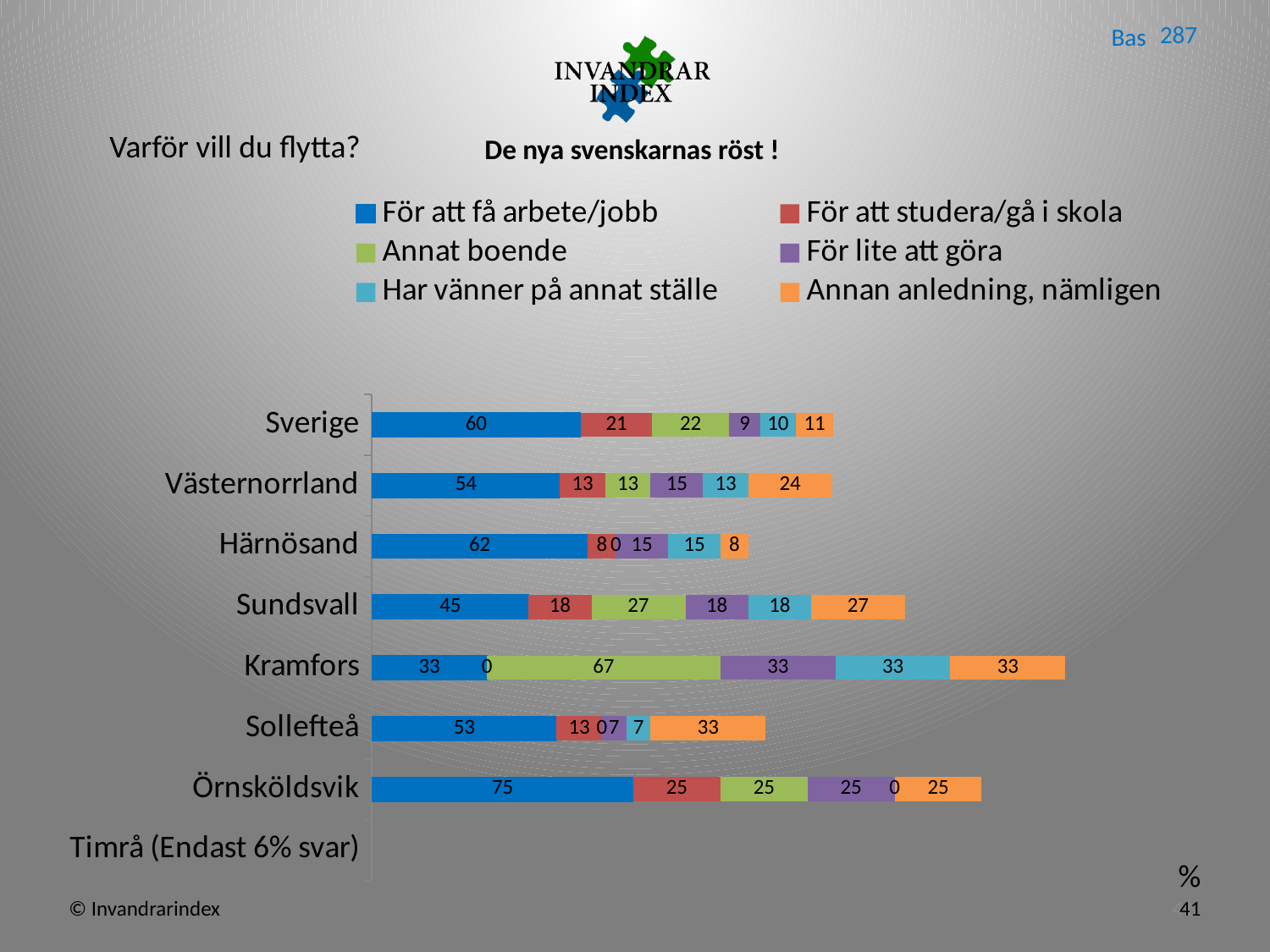
What is the value for 'Har vänner på annat ställe' for Sollefteå? 7 What is the value for 'Annat boende' for Kramfors? 67 Which category has the highest value for 'För att få arbete/jobb'? Örnsköldsvik What is the difference between the 'För att få arbete/jobb' values for Härnösand and Sundsvall? 17 Which category has the lowest value for 'För att få arbete/jobb'? Kramfors What kind of chart is shown on the slide? Stacked bar chart How many series does the legend list? 6 What is the value for 'För att få arbete/jobb' for Sverige? 60 What is the total of the stacked bar for Sverige? 133 What is the title of the chart? Varför vill du flytta? Which is larger, the 'För att studera/gå i skola' value for Sverige or for Sundsvall? Sverige What is the value for 'Annan anledning, nämligen' for Västernorrland? 24